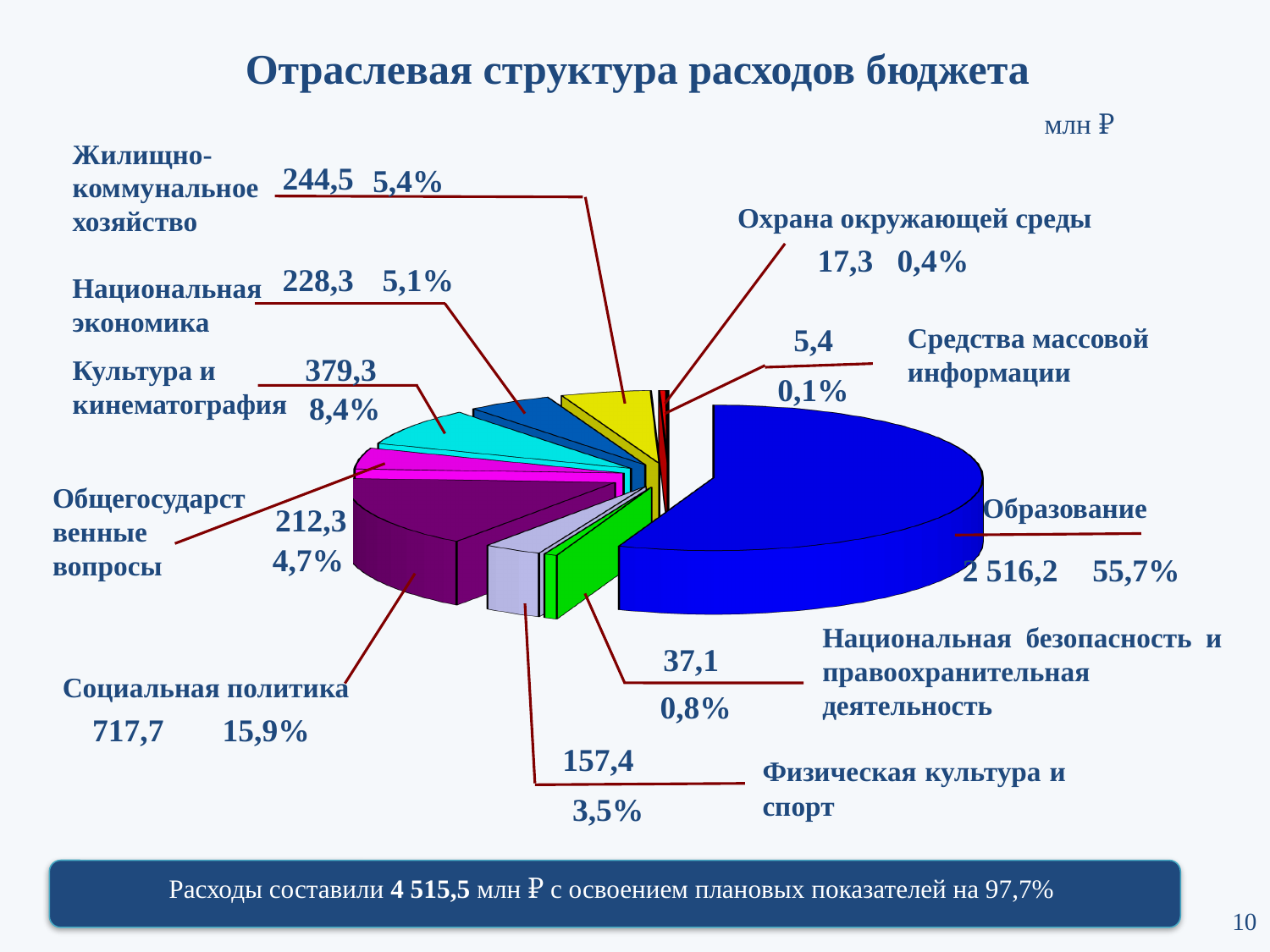
What is the value for Социальная политика in млн ₽? 717,7 What is the value for Охрана окружающей среды in млн ₽? 17,3 What is the title of the chart? Отраслевая структура расходов бюджета Which category has the largest value? Образование Which is larger: Жилищно-коммунальное хозяйство or Национальная экономика? Жилищно-коммунальное хозяйство What is the difference in млн ₽ between Социальная политика and Культура и кинематография? 338,4 What share of the pie does Образование represent? 55,7% Which category has the smallest value? Средства массовой информации What share of the pie does Культура и кинематография represent? 8,4% How many categories (slices) does the pie chart show? 10 What kind of chart is shown on the slide? pie chart What is the value for Образование in млн ₽? 2 516,2